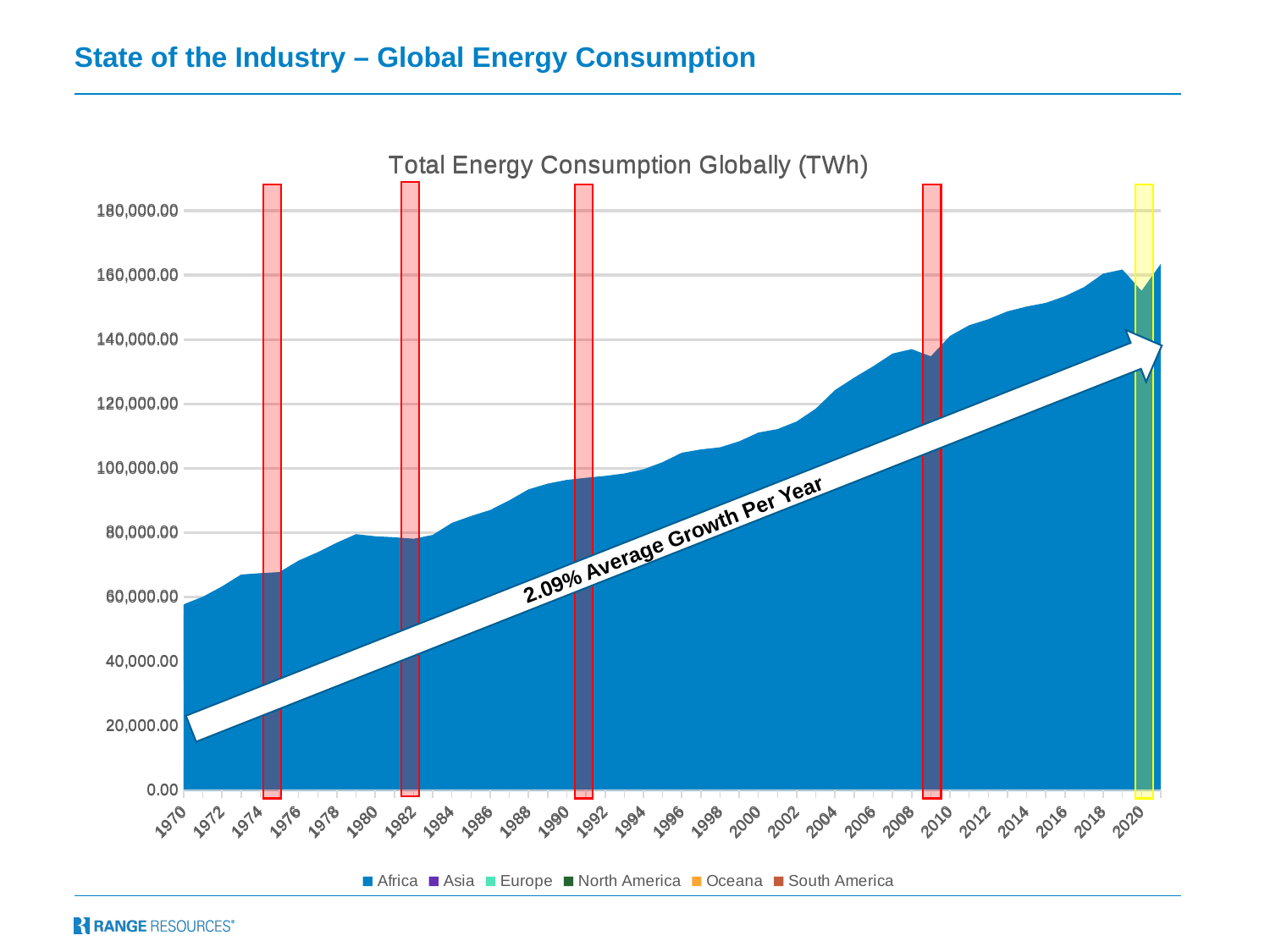
Do the values generally rise or fall from 1970 to 2020? Rise Which year on the x axis has the lowest total energy consumption? 1970 Is the value for 1990 greater or less than 100,000.00? less What is the title of the chart? Total Energy Consumption Globally (TWh) How many series does the chart legend list? 6 Is the value for 2000 greater or less than 100,000.00? greater What average growth per year is stated in the annotation on the chart? 2.09% Is the value for 2006 greater or less than 120,000.00? greater Which is larger, the value for 1980 or the value for 2010? 2010 What type of chart is shown on the slide? Area chart